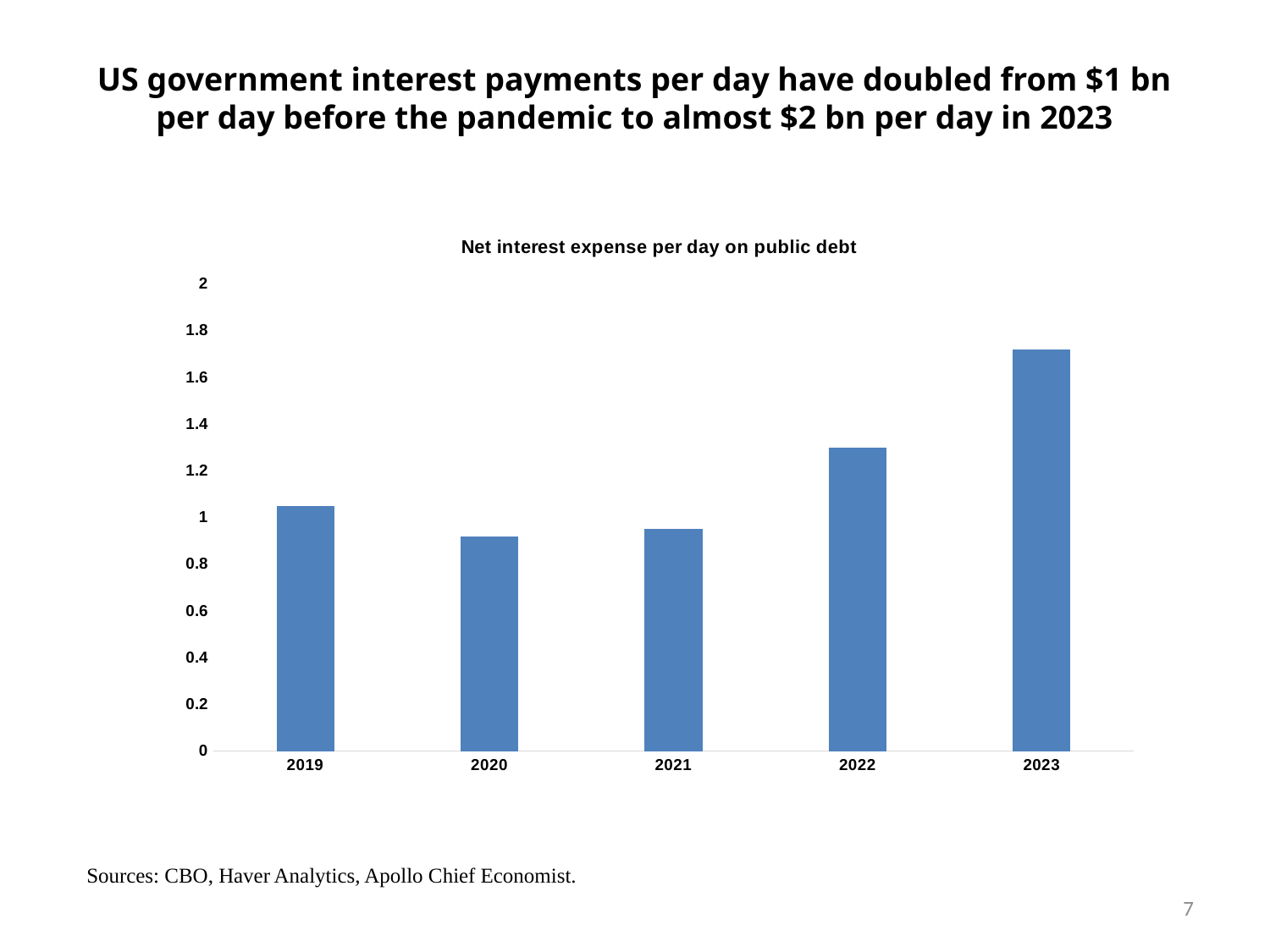
Which year has the larger value, 2022 or 2023? 2023 Is the value for 2021 greater or less than 1? less Which year has the highest net interest expense per day? 2023 Which year has the larger value, 2019 or 2020? 2019 What sources are cited for the chart? CBO, Haver Analytics, Apollo Chief Economist Is the value for 2020 greater or less than 1? less What kind of chart is shown on the slide? bar chart How many years are shown on the x axis of the chart? 5 What is the title of the chart? Net interest expense per day on public debt Do the values rise or fall from 2020 to 2023? rise Is the value for 2023 greater or less than 1.6? greater